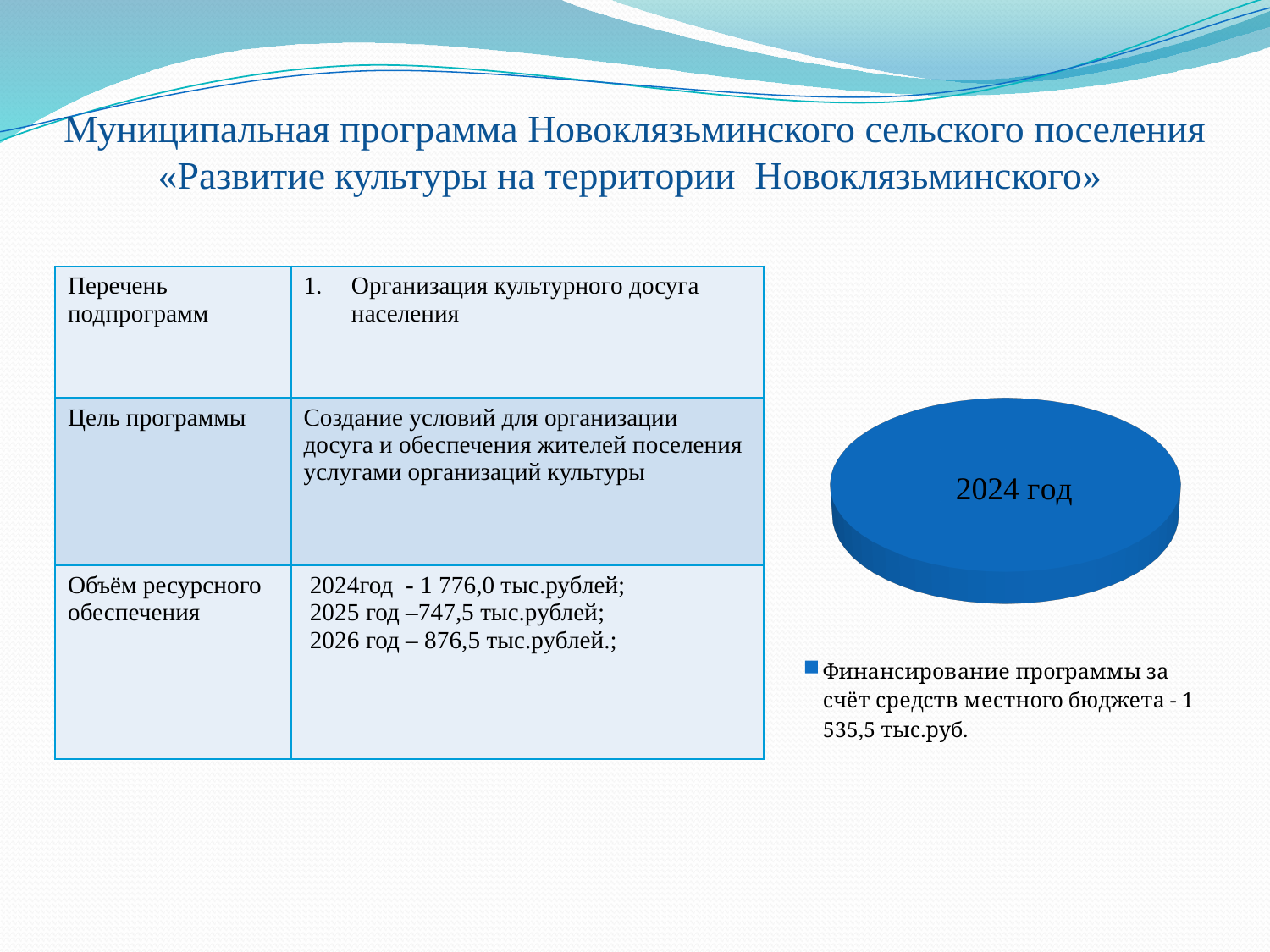
What share of the pie does the slice labelled "2024 год" represent? 100% How many slices does the pie chart contain? 1 What colour is the slice of the pie chart? Blue According to the legend of the pie chart, what amount of programme financing comes from the local budget? 1 535,5 тыс.руб. What kind of chart is shown on the right side of the slide? Pie chart What label is printed on the single slice of the pie chart? 2024 год How many entries does the legend of the pie chart list? 1